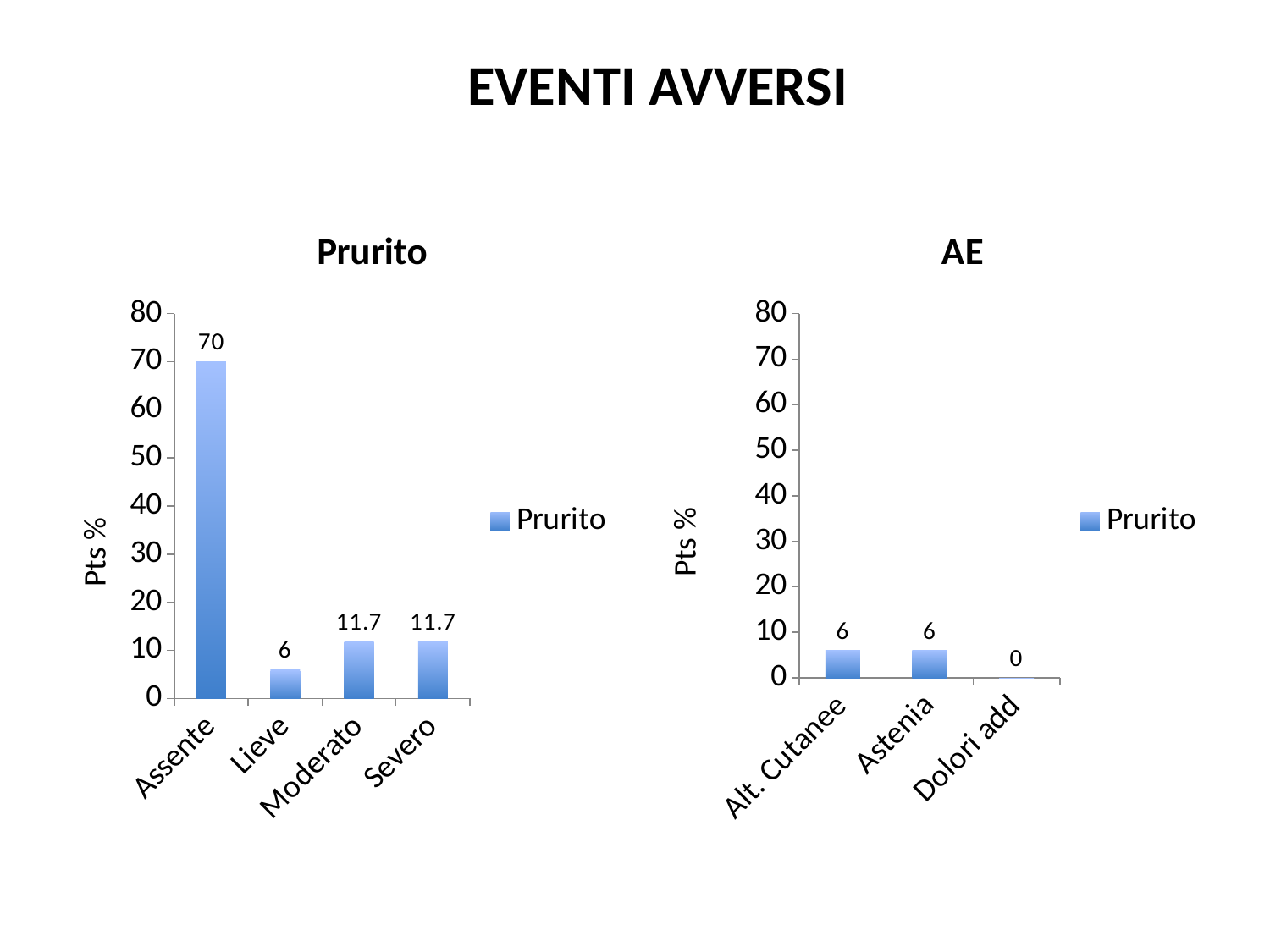
What kind of chart is the AE chart? Bar chart In the AE chart, what is the value for Dolori add? 0 In the Prurito chart, what is the difference between the values for Assente and Severo? 58.3 In the AE chart, what is the value for Astenia? 6 In the Prurito chart, which category has the highest value? Assente In the AE chart, which category has the lowest value? Dolori add In the Prurito chart, what is the value for Assente? 70 In the Prurito chart, which category has the lowest value? Lieve In the Prurito chart, how many categories are shown on the x axis? 4 In the Prurito chart, what is the value for Moderato? 11.7 What is the y-axis label of the Prurito chart? Pts % In the Prurito chart, what is the value for Lieve? 6